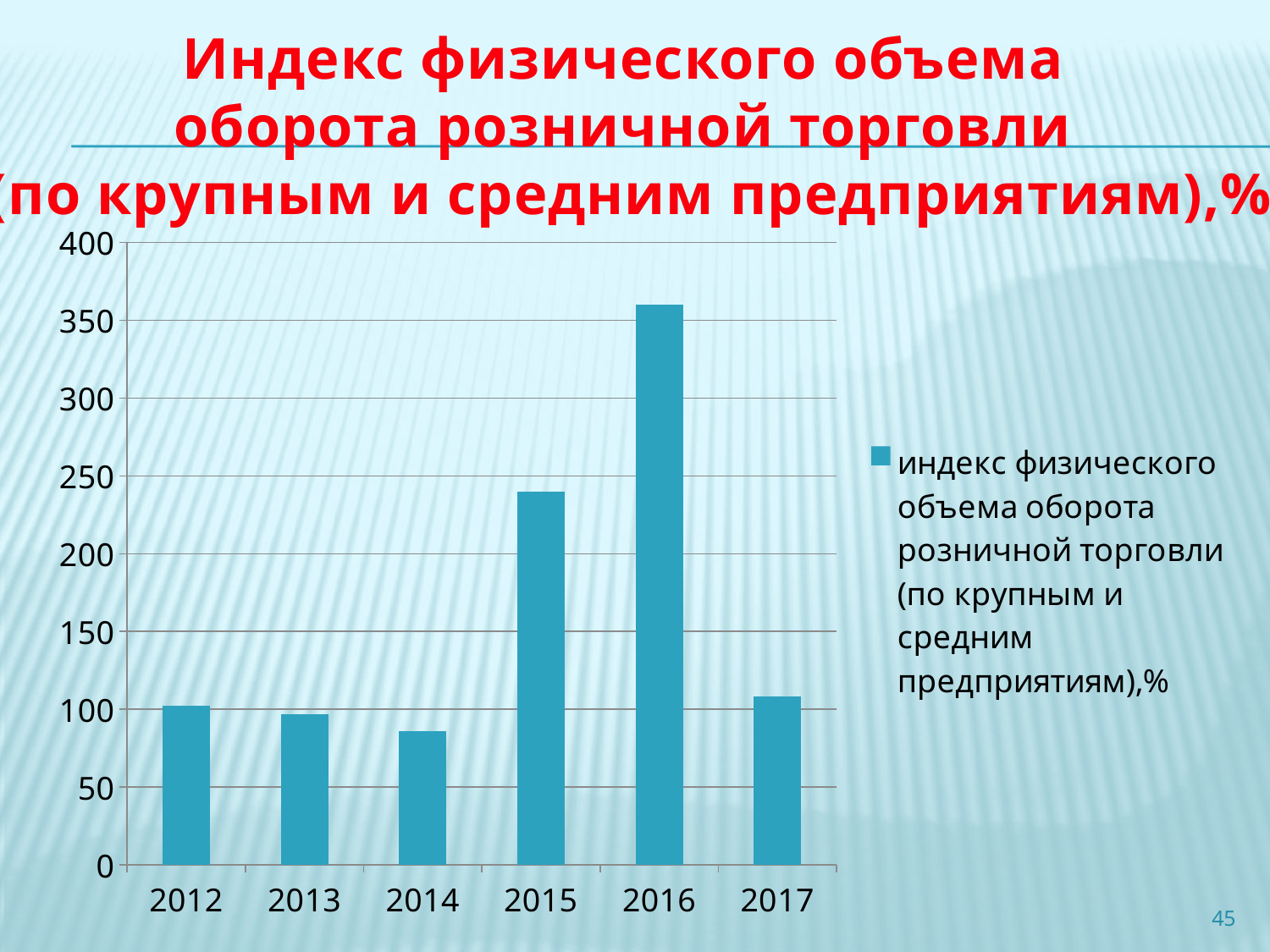
Is the value for 2014 greater or less than 100? less Is the value for 2016 greater or less than 300? greater Do the values rise or fall from 2014 to 2016? rise Which is larger, the value for 2012 or the value for 2014? 2012 Is the value for 2017 greater or less than 150? less What kind of chart is shown on the slide? bar chart How many years are shown on the x axis of the chart? 6 How many series does the legend list? 1 Which year has the lowest value in the chart? 2014 Which year has the highest value in the chart? 2016 Which is larger, the value for 2015 or the value for 2017? 2015